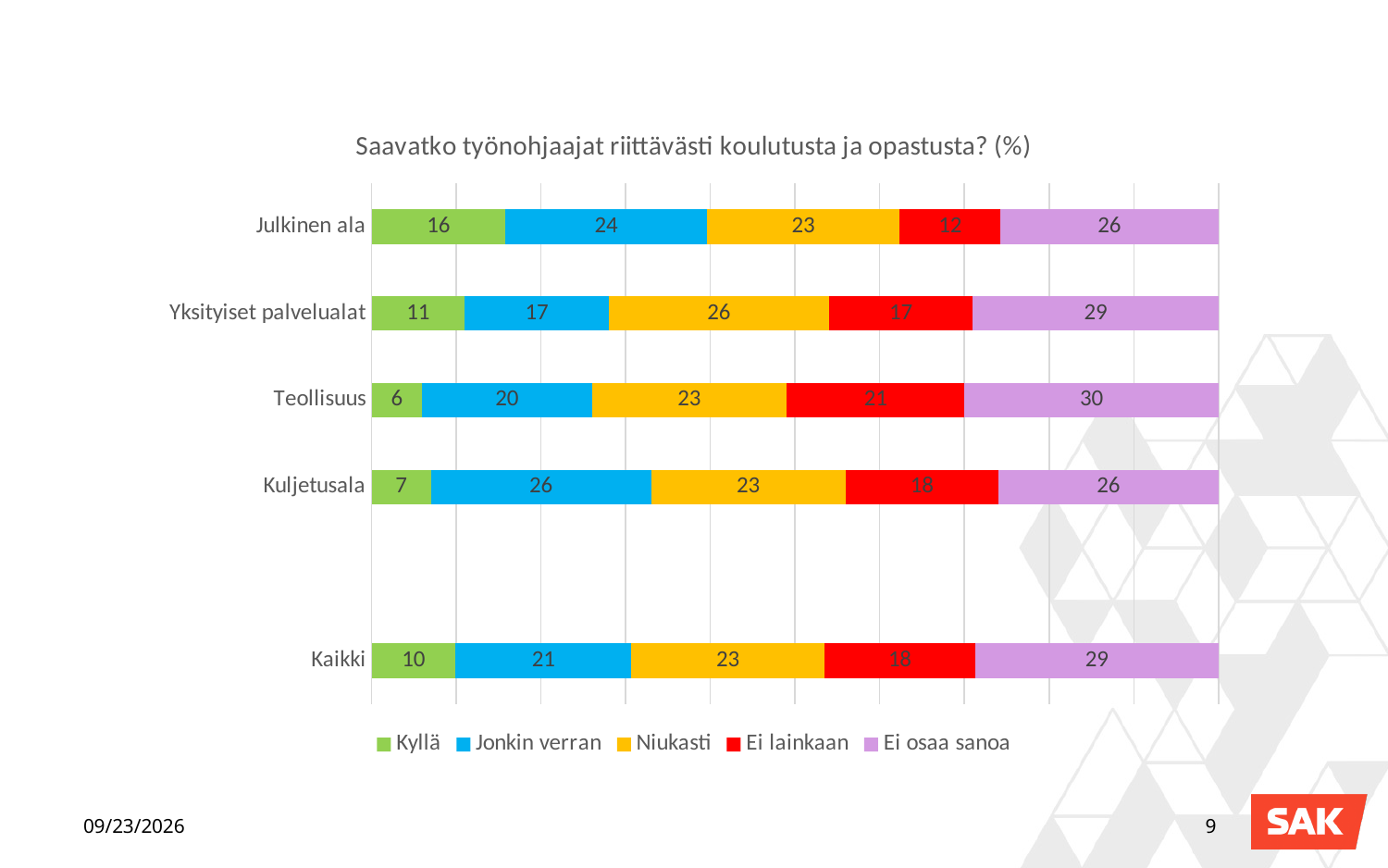
What is the Kyllä value for Julkinen ala? 16 Which is larger, the Niukasti value for Yksityiset palvelualat or for Kaikki? Yksityiset palvelualat What is the Ei osaa sanoa value for Teollisuus? 30 What is the Jonkin verran value for Kuljetusala? 26 Which category has the highest Kyllä value? Julkinen ala Which category has the lowest Kyllä value? Teollisuus How many categories are shown on the vertical axis? 5 What is the title of the chart? Saavatko työnohjaajat riittävästi koulutusta ja opastusta? (%) How many series does the legend list? 5 What type of chart is shown on the slide? Stacked bar chart What is the total of the stacked bar for Kuljetusala? 100 What is the difference between the Ei lainkaan values for Teollisuus and Julkinen ala? 9